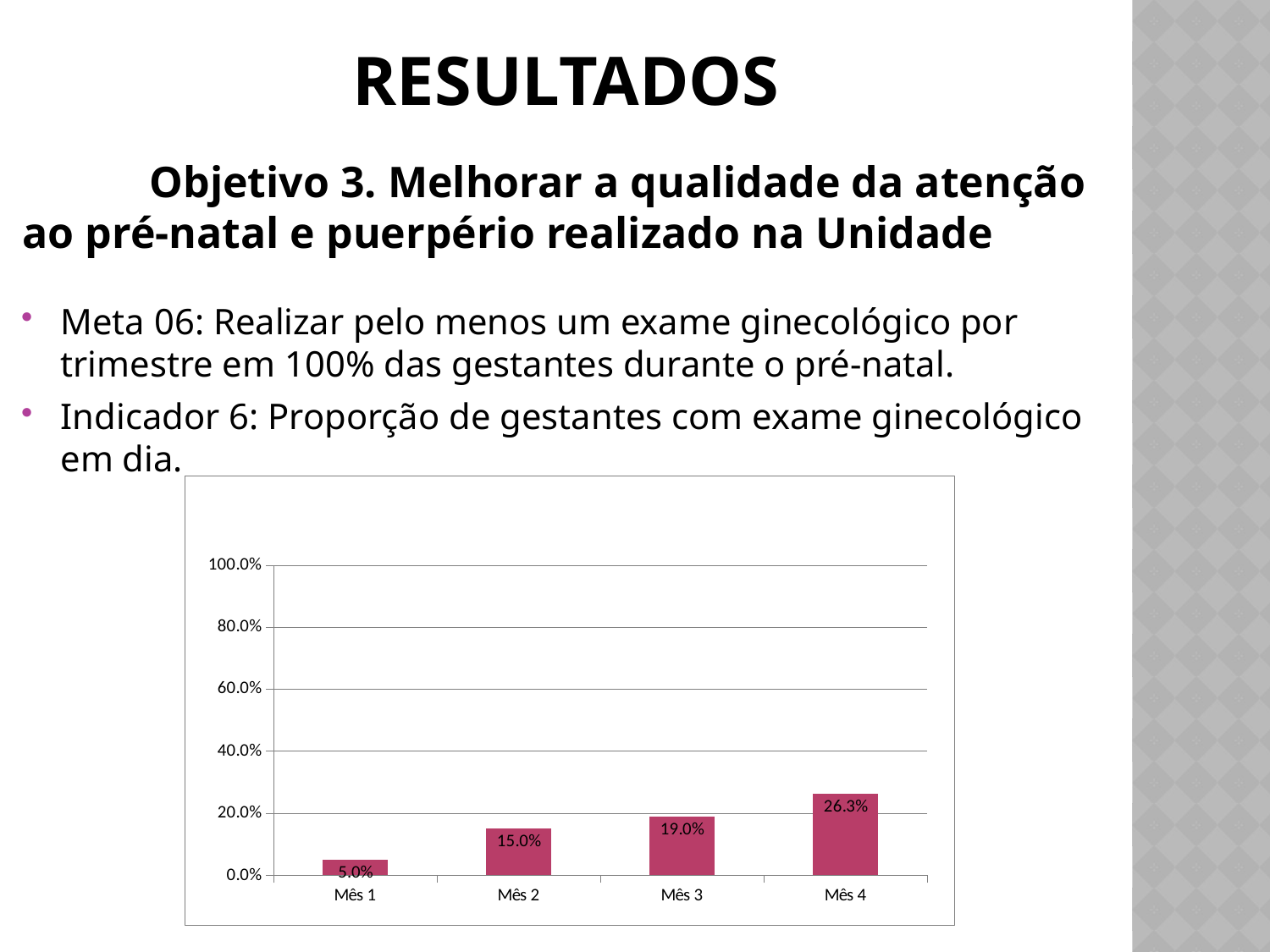
What is the value for Mês 2? 15.0% What is the value for Mês 1? 5.0% How many months are shown on the x axis? 4 Which is larger, the value for Mês 2 or the value for Mês 3? Mês 3 Which month has the highest value? Mês 4 What is the difference between the values for Mês 4 and Mês 1? 21.3% What is the difference between the values for Mês 3 and Mês 2? 4.0% What is the value for Mês 4? 26.3% Is the value for Mês 4 greater or less than 20.0%? greater What kind of chart is shown on the slide? bar chart What is the value for Mês 3? 19.0% Which month has the lowest value? Mês 1